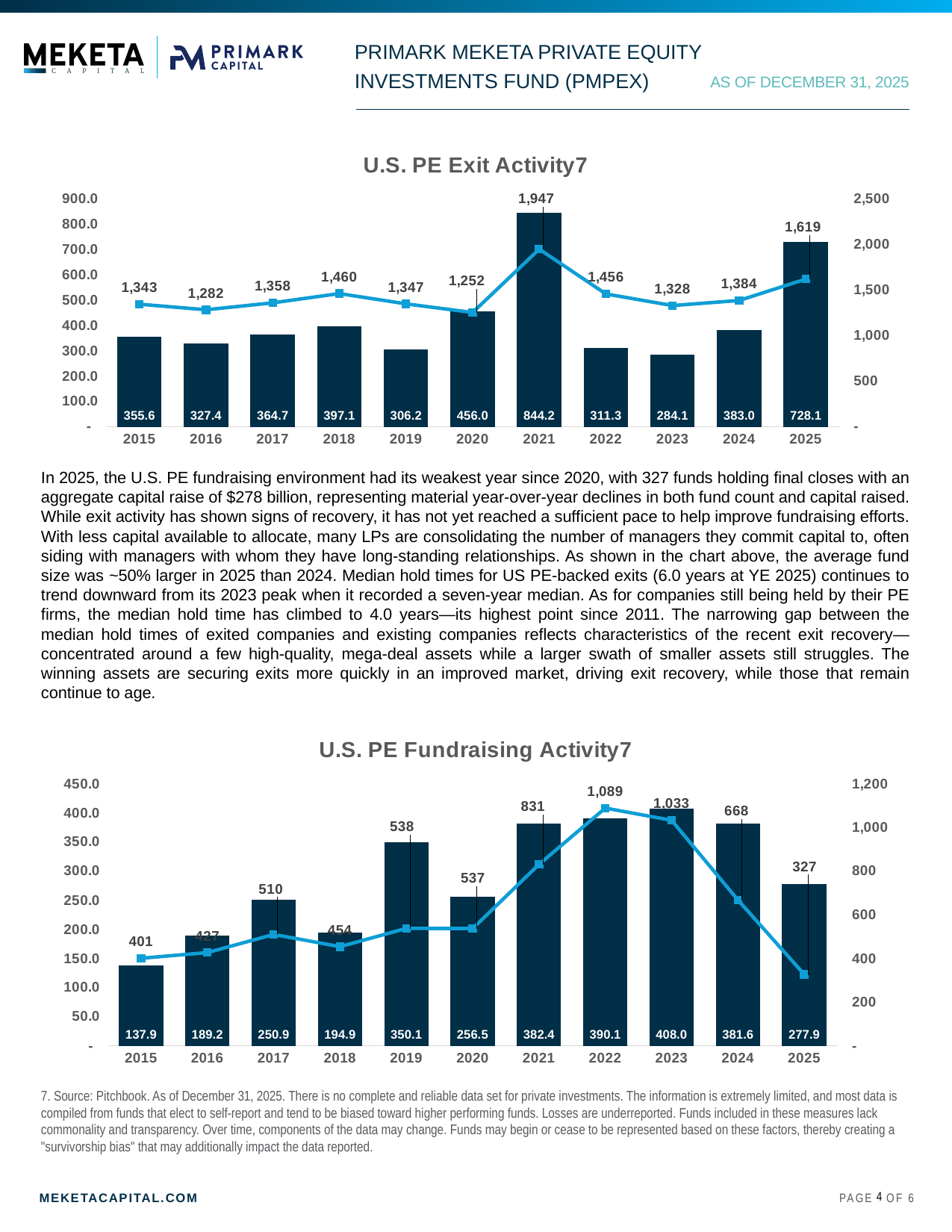
In the U.S. PE Fundraising Activity chart, what is the bar value for 2023? 408.0 In the U.S. PE Fundraising Activity chart, which year has the lowest bar value? 2015 In the U.S. PE Fundraising Activity chart, what is the difference between the line values for 2024 and 2025? 341 In the U.S. PE Fundraising Activity chart, what is the line value for 2022? 1,089 In the U.S. PE Exit Activity chart, how many years are shown on the x axis? 11 In the U.S. PE Exit Activity chart, what is the line value for 2025? 1,619 What kind of chart is the U.S. PE Fundraising Activity chart? Combined bar and line chart In the U.S. PE Exit Activity chart, what is the bar value for 2021? 844.2 In the U.S. PE Fundraising Activity chart, is the bar value for 2019 larger or smaller than the bar value for 2020? larger In the U.S. PE Exit Activity chart, which year has the lowest bar value? 2023 In the U.S. PE Exit Activity chart, what is the difference between the bar values for 2021 and 2025? 116.1 In the U.S. PE Exit Activity chart, which year has the highest line value? 2021